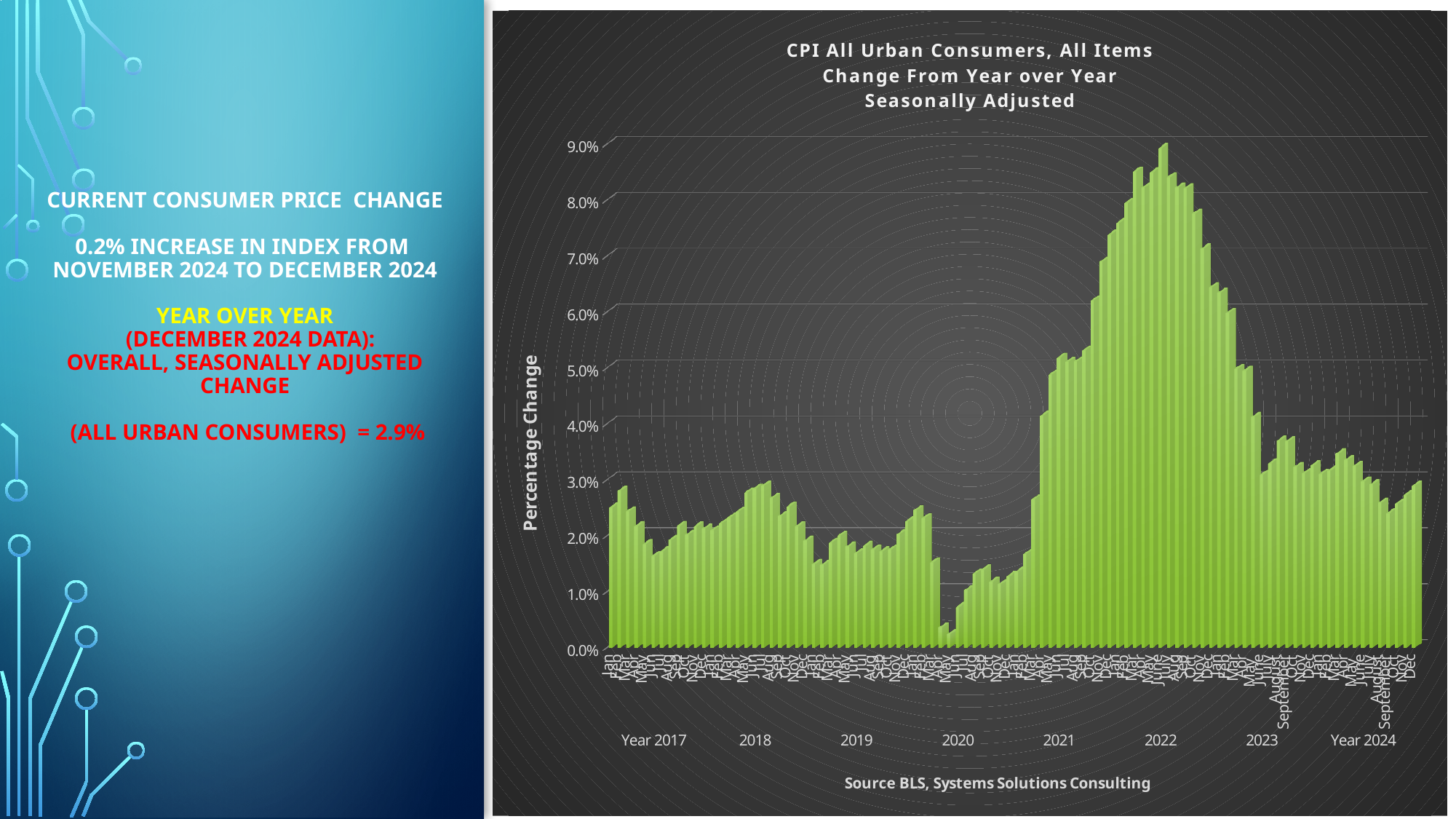
Do the values rise or fall from the 2022 peak through 2023? Fall In which year does the chart show its lowest percentage change? 2020 Do the values rise or fall over the course of 2021? Rise What is the title of the chart? CPI All Urban Consumers, All Items Change From Year over Year Seasonally Adjusted In which year does the chart reach its highest percentage change? 2022 Is the peak value in 2022 greater or less than 8.0%? greater Is the lowest value in 2020 greater or less than 1.0%? less Are the values in 2017 greater or less than 4.0%? less What kind of chart is shown on the slide? Bar chart What is the label on the vertical axis of the chart? Percentage Change How many years are labeled along the horizontal axis of the chart? 8 Which year has higher values overall, 2022 or 2019? 2022